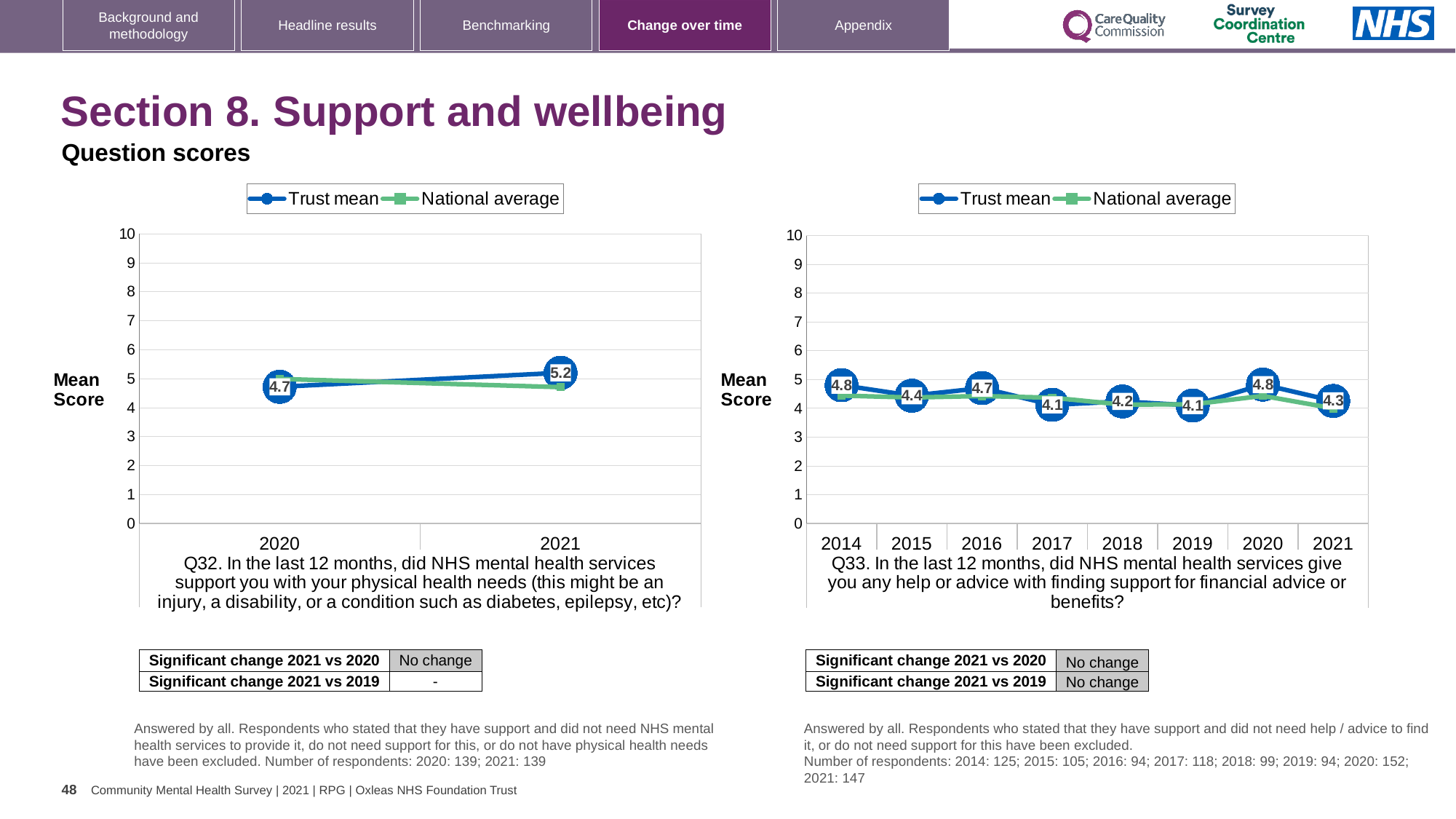
In the Q33 chart on the right, how many years are shown on the x axis? 8 How many series does the legend of the Q33 chart on the right list? 2 In the Q32 chart on the left, what is the Trust mean for 2020? 4.7 In the Q32 chart on the left, by how much did the Trust mean change from 2020 to 2021? 0.5 What type of chart is the Q32 chart on the left? Line chart In the Q33 chart on the right, what is the difference between the Trust mean in 2020 and in 2021? 0.5 In the Q33 chart on the right, which year has the lowest Trust mean? 2017 and 2019 In the Q33 chart on the right, is the Trust mean for 2020 larger than the Trust mean for 2015? Yes In the Q33 chart on the right, what is the Trust mean for 2017? 4.1 In the Q32 chart on the left, does the Trust mean rise or fall from 2020 to 2021? rise In the Q32 chart on the left, what is the Trust mean for 2021? 5.2 In the Q33 chart on the right, what is the Trust mean for 2021? 4.3